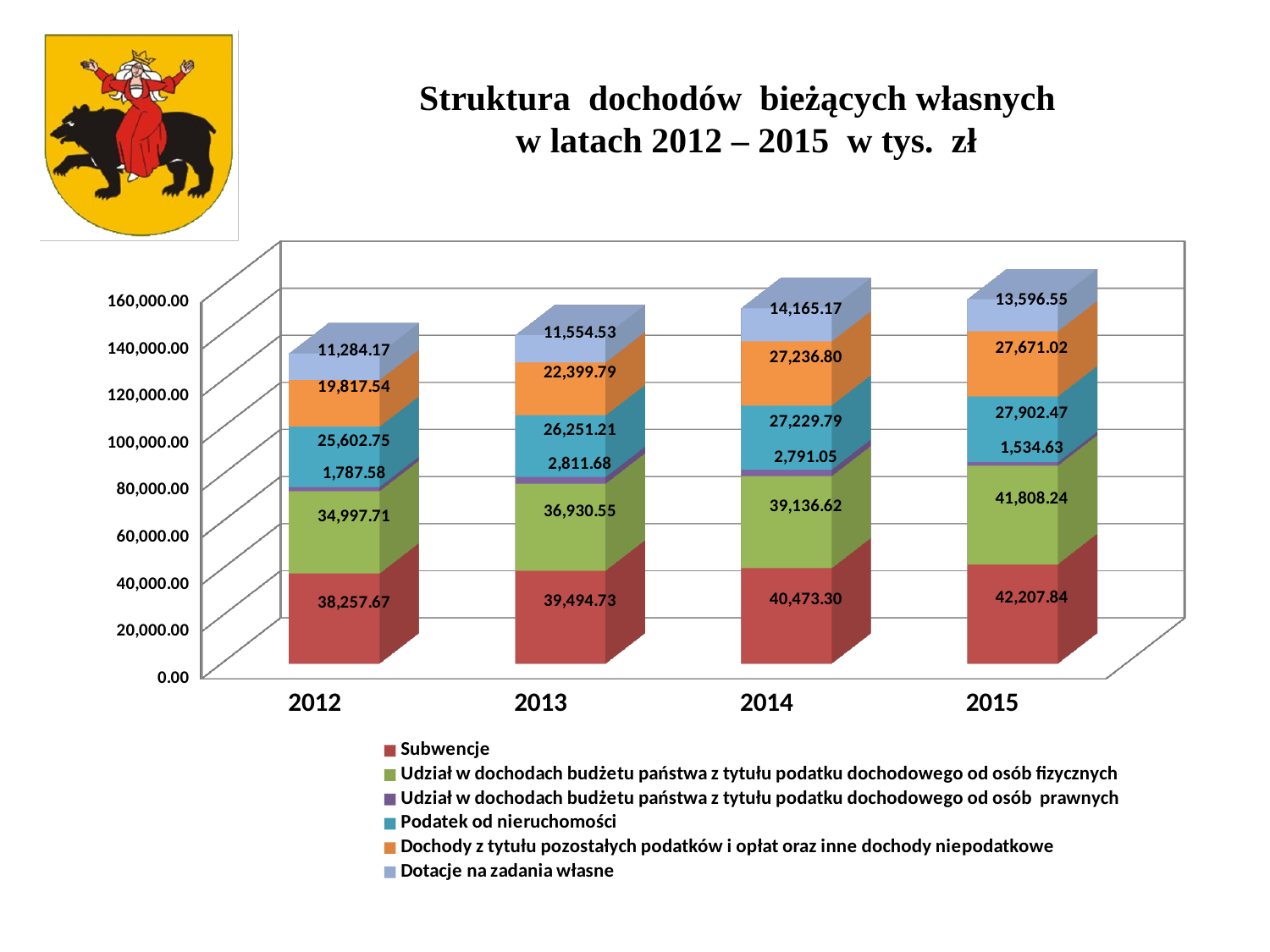
How many series does the legend list? 6 What is the value of Podatek od nieruchomości for 2014? 27,229.79 What is the difference between the Subwencje values for 2015 and 2012? 3,950.17 In which year is the value for Udział w dochodach budżetu państwa z tytułu podatku dochodowego od osób prawnych the lowest? 2015 How many years are shown on the x axis? 4 What kind of chart is shown on the slide? Stacked bar chart What is the value of Subwencje for 2012? 38,257.67 Which year has the larger value for Dotacje na zadania własne, 2014 or 2015? 2014 What is the total of the stacked bar for 2015? 154,720.75 In which year is the Subwencje value the highest? 2015 Do the Subwencje values rise or fall from 2012 to 2015? Rise What is the value of Dotacje na zadania własne for 2013? 11,554.53